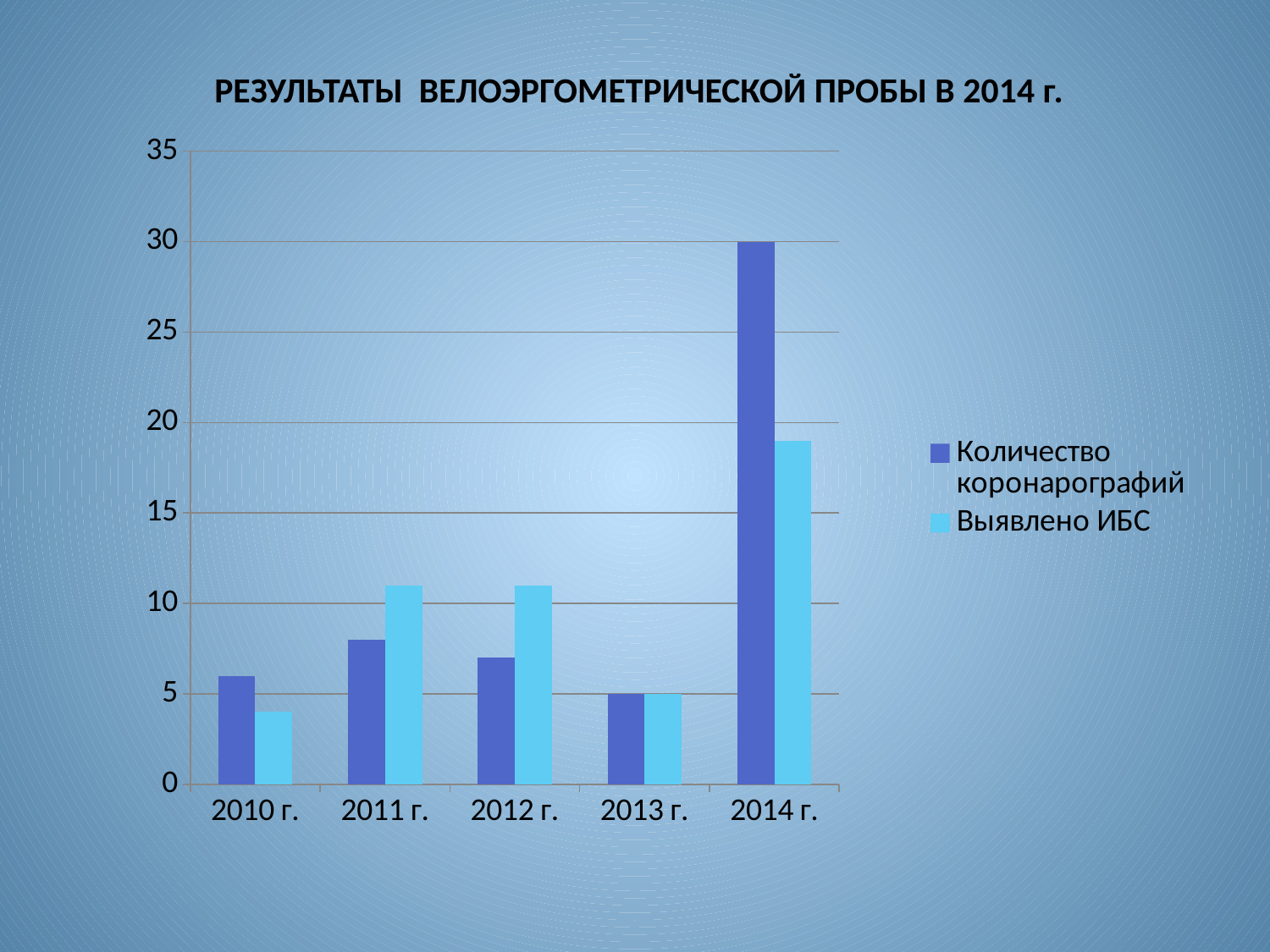
What is the value of Выявлено ИБС for 2013 г.? 5 Is the value of Выявлено ИБС for 2012 г. greater or less than 10? greater For 2011 г., which series has the larger value: Количество коронарографий or Выявлено ИБС? Выявлено ИБС Is the value of Выявлено ИБС for 2014 г. greater or less than 15? greater What is the title of the chart? РЕЗУЛЬТАТЫ ВЕЛОЭРГОМЕТРИЧЕСКОЙ ПРОБЫ В 2014 г. How many series does the legend list? 2 How many years are shown on the x axis? 5 What is the value of Количество коронарографий for 2014 г.? 30 Which year has the highest value for Количество коронарографий? 2014 г. What kind of chart is shown on the slide? bar chart Which year has the lowest value for Выявлено ИБС? 2010 г. Is the value of Количество коронарографий for 2011 г. greater or less than 10? less